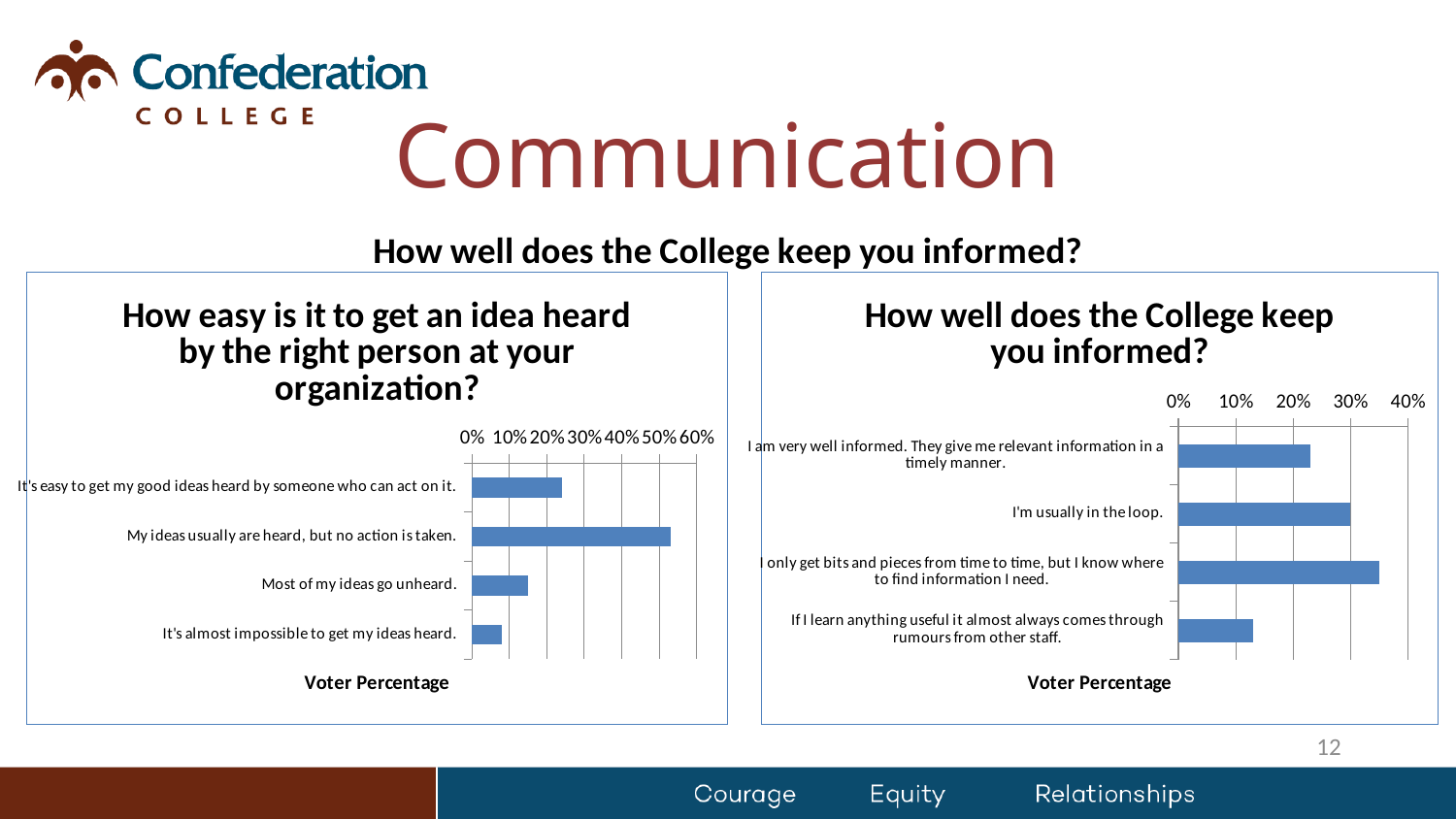
In the right chart, 'How well does the College keep you informed?', is the value for 'I'm usually in the loop.' greater or less than 20%? greater In the left chart, 'How easy is it to get an idea heard by the right person at your organization?', is the value for 'It's almost impossible to get my ideas heard.' greater or less than 10%? less In the left chart, 'How easy is it to get an idea heard by the right person at your organization?', which is larger: 'It's easy to get my good ideas heard by someone who can act on it.' or 'Most of my ideas go unheard.'? It's easy to get my good ideas heard by someone who can act on it. In the right chart, 'How well does the College keep you informed?', which category has the lowest voter percentage? If I learn anything useful it almost always comes through rumours from other staff. In the right chart, 'How well does the College keep you informed?', which category has the highest voter percentage? I only get bits and pieces from time to time, but I know where to find information I need. In the left chart, 'How easy is it to get an idea heard by the right person at your organization?', how many categories are plotted? 4 In the left chart, 'How easy is it to get an idea heard by the right person at your organization?', is the value for 'My ideas usually are heard, but no action is taken.' greater or less than 40%? greater What is the axis title shown below the bars in the right chart, 'How well does the College keep you informed?'? Voter Percentage In the right chart, 'How well does the College keep you informed?', which is larger: 'I am very well informed. They give me relevant information in a timely manner.' or 'I'm usually in the loop.'? I'm usually in the loop. What type of chart is used in the left chart, 'How easy is it to get an idea heard by the right person at your organization?'? bar chart In the left chart, 'How easy is it to get an idea heard by the right person at your organization?', which category has the highest voter percentage? My ideas usually are heard, but no action is taken. In the left chart, 'How easy is it to get an idea heard by the right person at your organization?', which category has the lowest voter percentage? It's almost impossible to get my ideas heard.